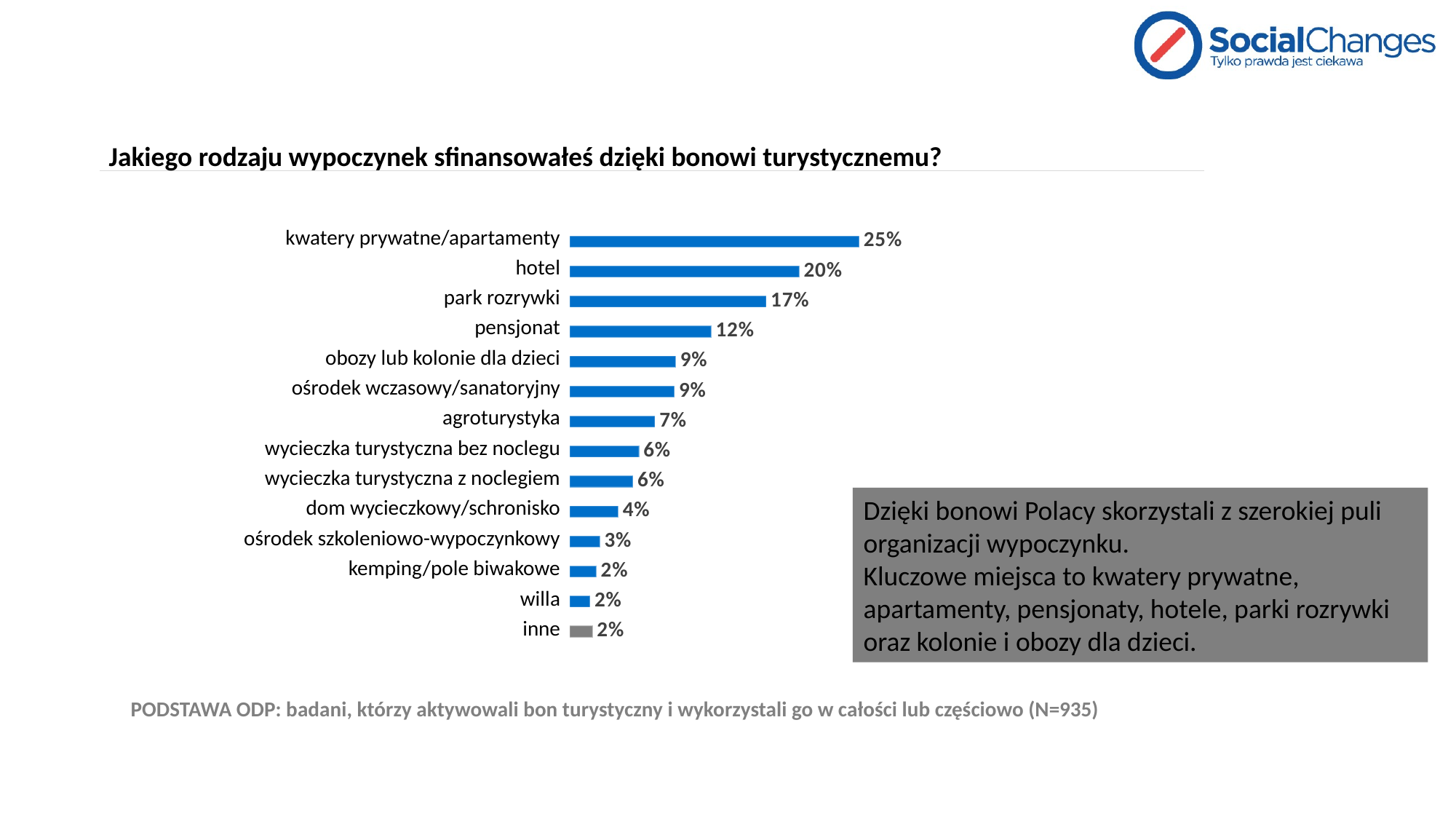
What is the value for "hotel"? 20% How many categories are shown in the chart? 14 What is the value for "dom wycieczkowy/schronisko"? 4% Which category's bar is coloured grey instead of blue? inne What kind of chart is shown on the slide? bar chart Which is larger, the value for "park rozrywki" or the value for "obozy lub kolonie dla dzieci"? park rozrywki What is the value for "ośrodek szkoleniowo-wypoczynkowy"? 3% What is the value for "agroturystyka"? 7% Which category has the highest value? kwatery prywatne/apartamenty What is the difference between the values for "kwatery prywatne/apartamenty" and "hotel"? 5% What is the difference between the values for "park rozrywki" and "pensjonat"? 5% What is the value for "pensjonat"? 12%